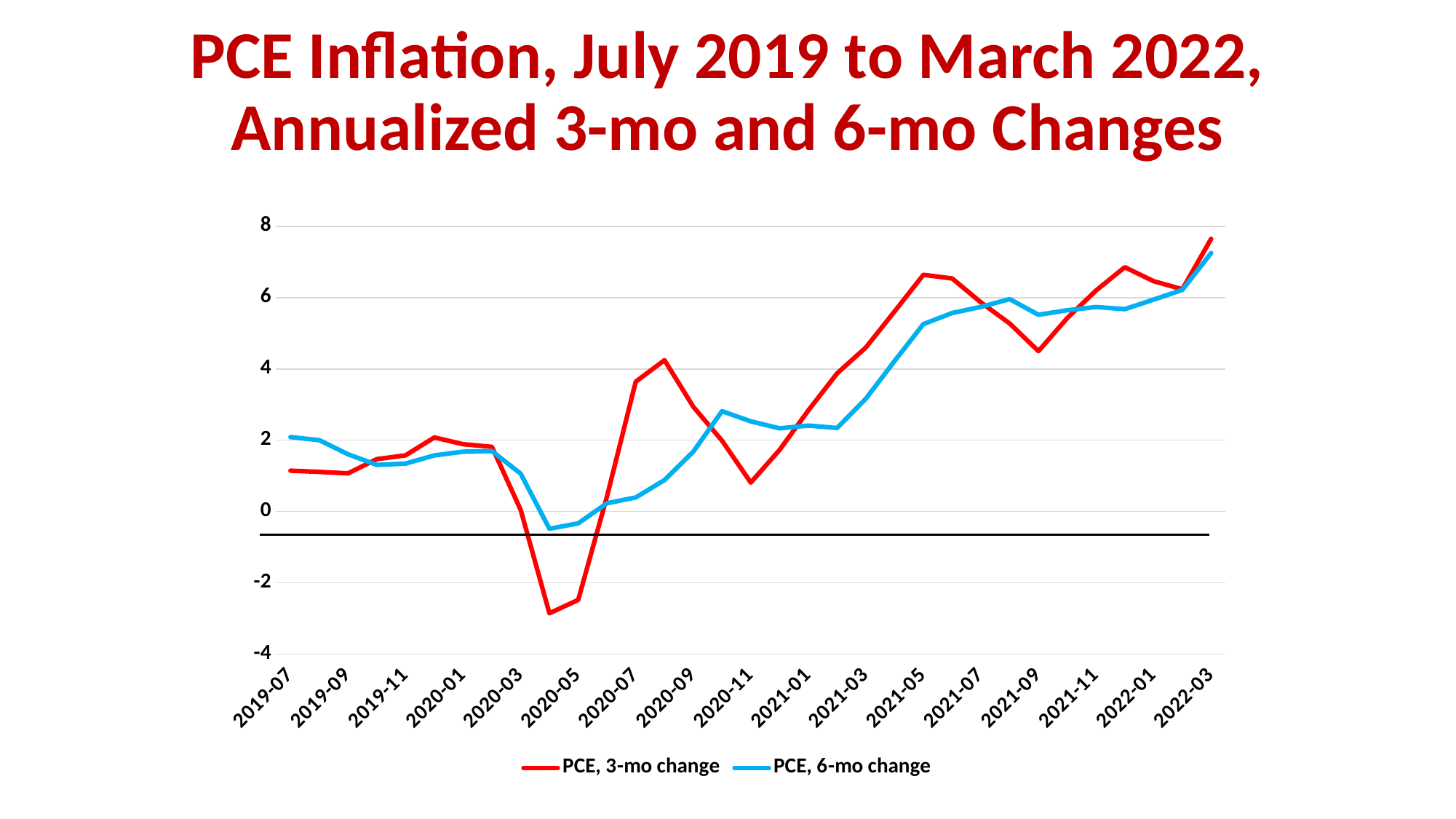
At 2021-09, which series has the higher value, PCE, 3-mo change or PCE, 6-mo change? PCE, 6-mo change Is the value of PCE, 6-mo change at 2021-09 greater or less than 4? greater Is the value of PCE, 3-mo change at 2020-05 greater or less than -2? less What kind of chart is shown on the slide? Line chart How many series does the legend list? 2 What is the title of the chart? PCE Inflation, July 2019 to March 2022, Annualized 3-mo and 6-mo Changes Is the value of PCE, 3-mo change at 2022-03 greater or less than 6? greater At 2021-05, which series has the higher value, PCE, 3-mo change or PCE, 6-mo change? PCE, 3-mo change At which x-axis date does the PCE, 3-mo change line reach its highest value? 2022-03 What colour is the line for PCE, 3-mo change? Red